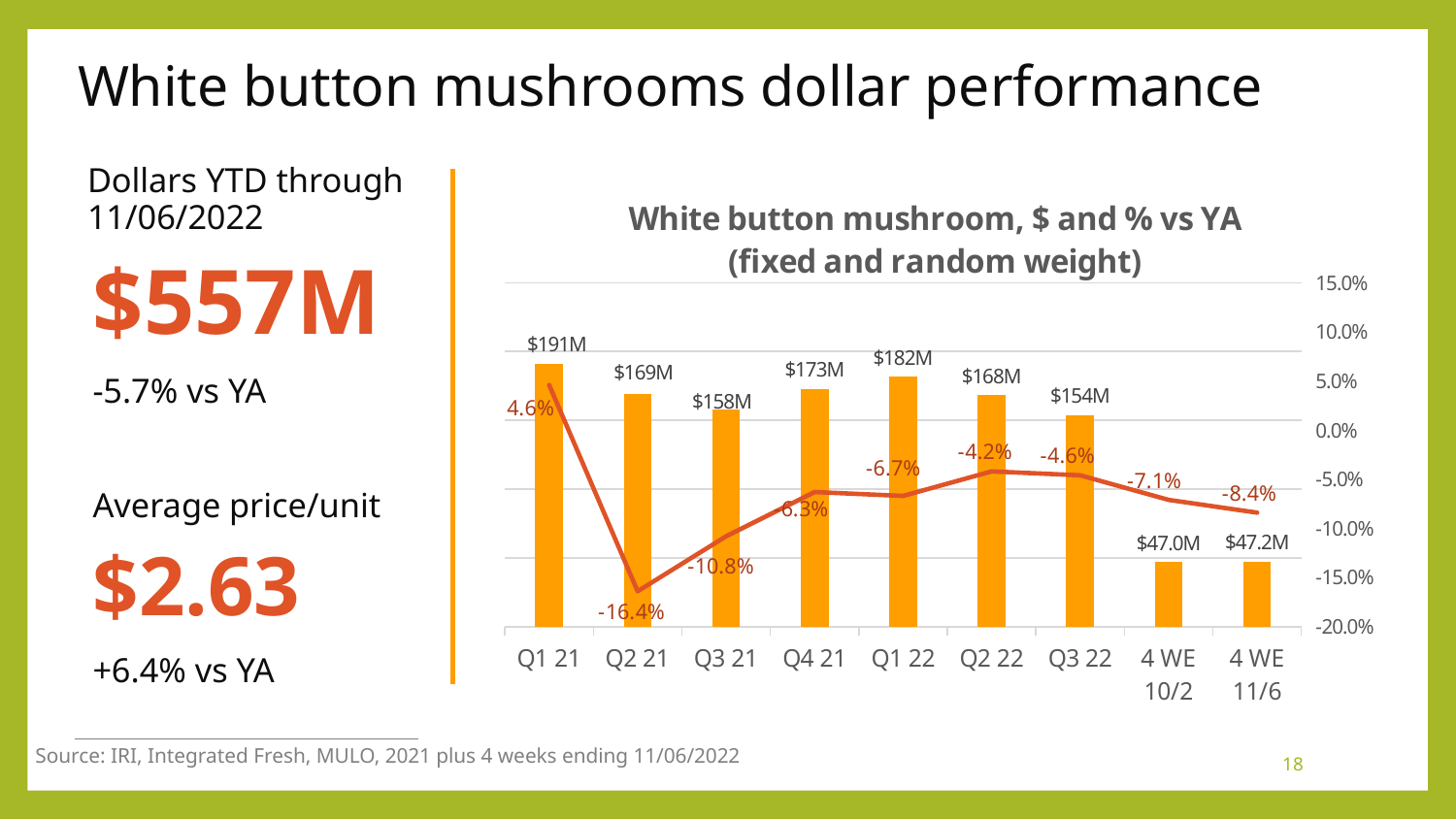
What is the % vs YA value for Q2 21? -16.4% What is the dollar value for the 4 WE 11/6 period? $47.2M What is the difference in dollars between Q1 22 and Q2 22? $14M Which period has the lowest % vs YA value? Q2 21 Which is larger, the dollar value for Q3 21 or Q4 21? Q4 21 Does the % vs YA line rise or fall from Q2 21 to Q2 22? Rise Which quarter has the highest dollar value? Q1 21 What is the % vs YA value for Q2 22? -4.2% What kind of chart is this? Combined bar and line chart What is the dollar value for Q1 21? $191M What is the title of the chart? White button mushroom, $ and % vs YA (fixed and random weight) How many periods are shown on the x axis? 9